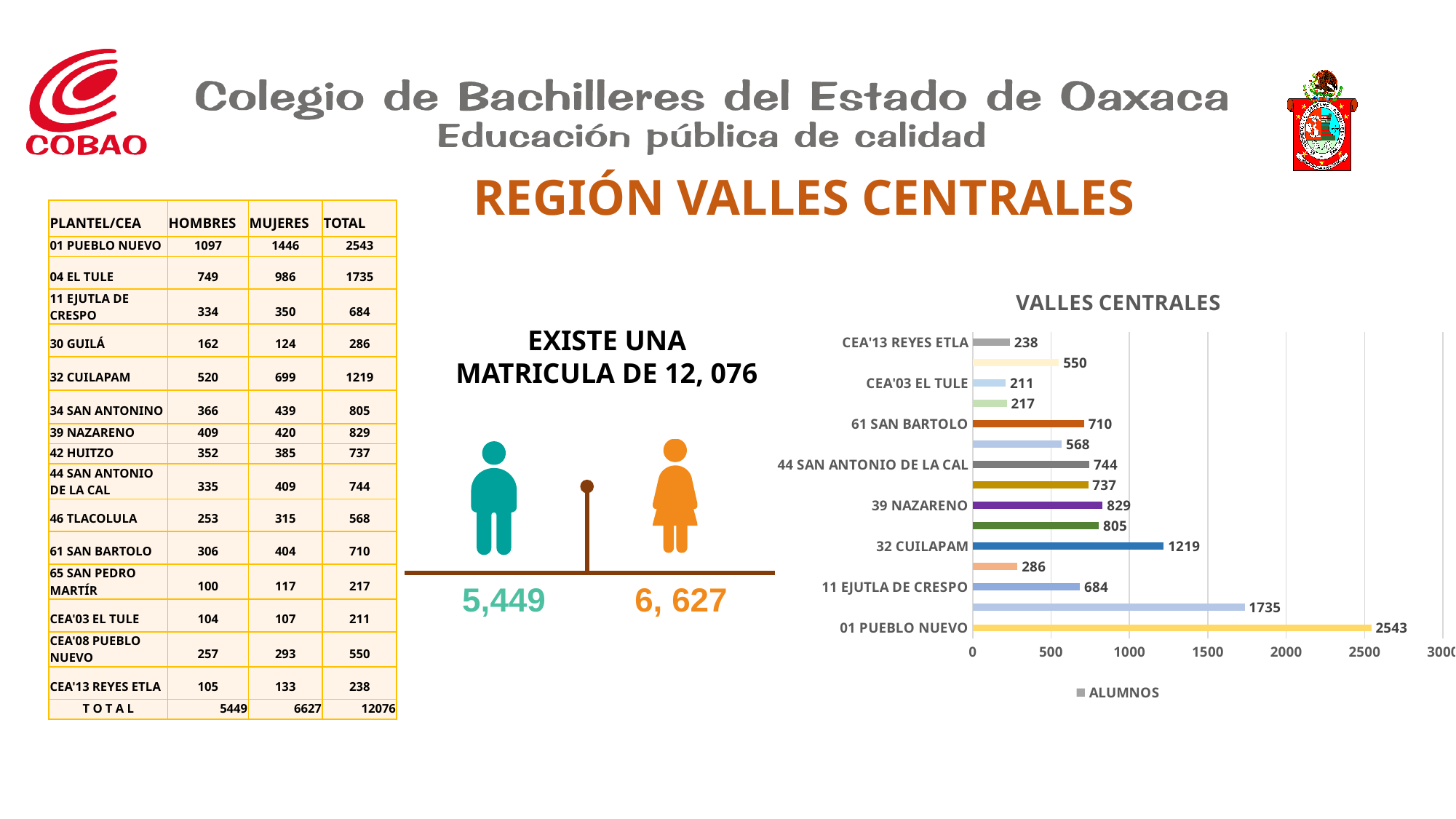
In the VALLES CENTRALES chart, what is the difference between the values for 01 PUEBLO NUEVO and 32 CUILAPAM? 1324 In the VALLES CENTRALES chart, which labeled category has the highest value? 01 PUEBLO NUEVO In the VALLES CENTRALES chart, which labeled category has the lowest value? CEA'03 EL TULE What is the single legend entry shown below the VALLES CENTRALES chart? ALUMNOS In the VALLES CENTRALES chart, what is the value for CEA'13 REYES ETLA? 238 In the VALLES CENTRALES chart, what is the difference between the values for 39 NAZARENO and 61 SAN BARTOLO? 119 What type of chart is shown under the title VALLES CENTRALES? bar chart In the VALLES CENTRALES chart, what is the value for 32 CUILAPAM? 1219 In the VALLES CENTRALES chart, what is the value for 39 NAZARENO? 829 In the VALLES CENTRALES chart, which is larger: the value for 44 SAN ANTONIO DE LA CAL or the value for 61 SAN BARTOLO? 44 SAN ANTONIO DE LA CAL In the VALLES CENTRALES chart, is the value for 11 EJUTLA DE CRESPO greater or less than 1000? less How many bars are plotted in the VALLES CENTRALES chart? 15